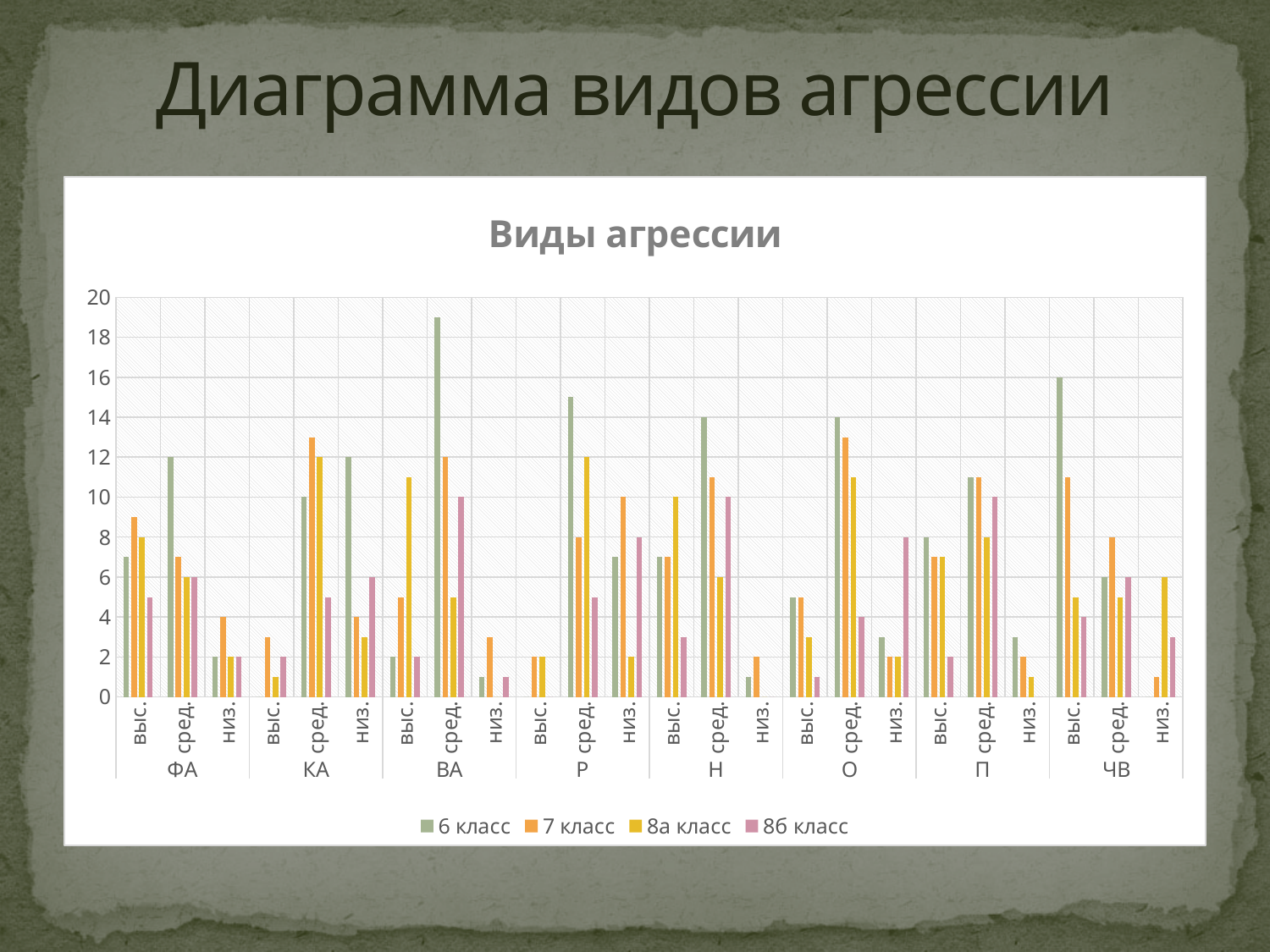
In the ФА сред. category, which is larger: 6 класс or 7 класс? 6 класс How many series does the legend list? 4 What is the title of the chart? Виды агрессии What is the value for 6 класс in the ЧВ выс. category? 16 Which category and series has the tallest bar in the chart? ВА сред., 6 класс How many main category groups (ФА, КА, ...) are shown along the x axis? 8 What is the value for 6 класс in the ФА сред. category? 12 What is the difference between the 6 класс value in ЧВ выс. and the 6 класс value in ФА сред.? 4 What is the value for 8б класс in the ВА сред. category? 10 What type of chart is shown on the slide? bar chart Is the value for 6 класс in the ВА сред. category greater or less than 18? greater What is the value for 6 класс in the Н сред. category? 14